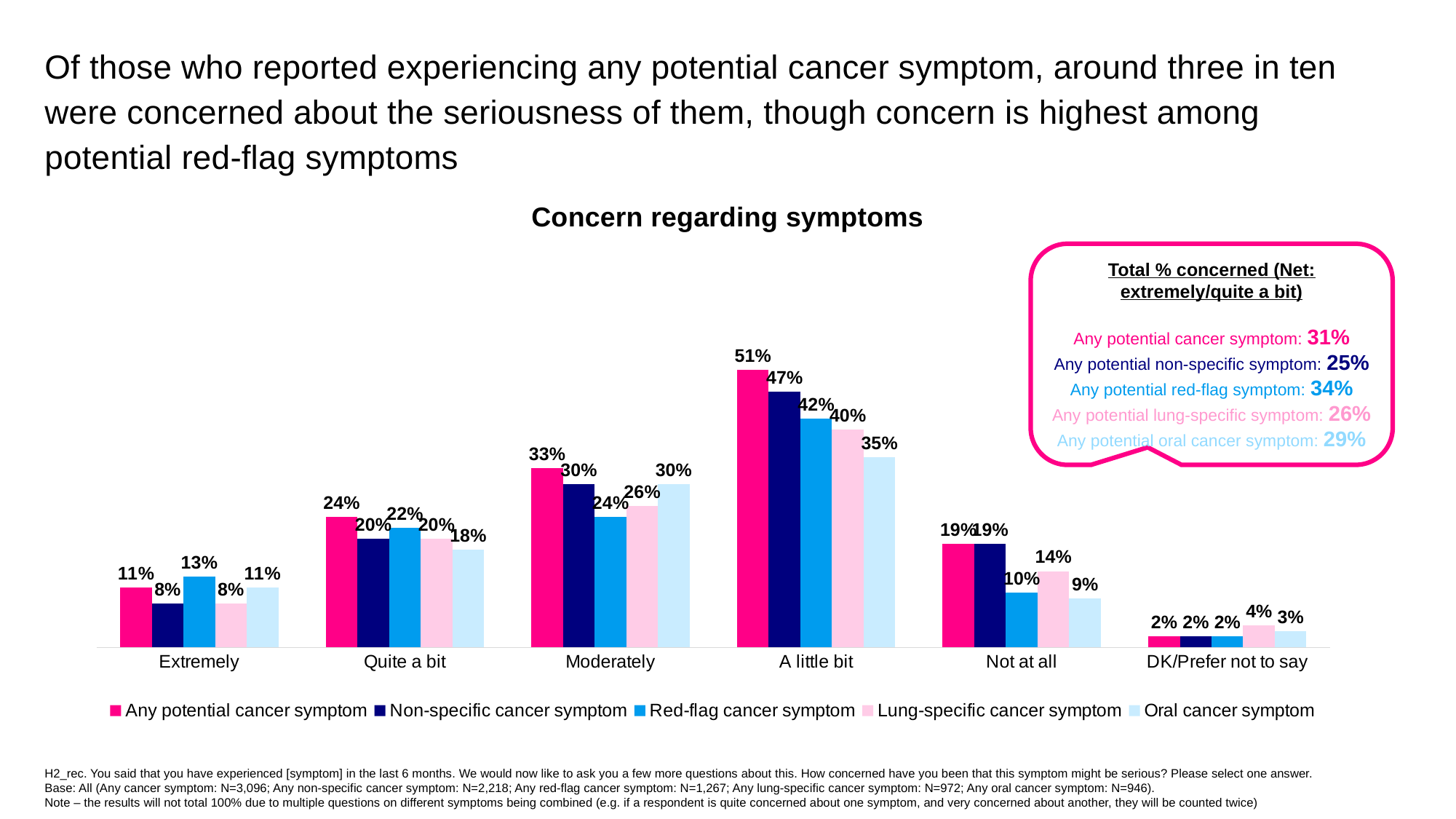
Which category has the highest value for the Any potential cancer symptom series? A little bit What is the value for Any potential cancer symptom in the A little bit category? 51% How many series does the legend list? 5 What kind of chart is this? Bar chart Which series has the lowest value in the A little bit category? Oral cancer symptom How many categories are shown on the x axis? 6 What is the value for Red-flag cancer symptom in the Extremely category? 13% What is the title of the chart? Concern regarding symptoms What is the difference between Any potential cancer symptom and Oral cancer symptom in the A little bit category? 16% What is the value for Oral cancer symptom in the Moderately category? 30% What is the value for Lung-specific cancer symptom in the Not at all category? 14% In the Moderately category, which is larger: Non-specific cancer symptom or Red-flag cancer symptom? Non-specific cancer symptom